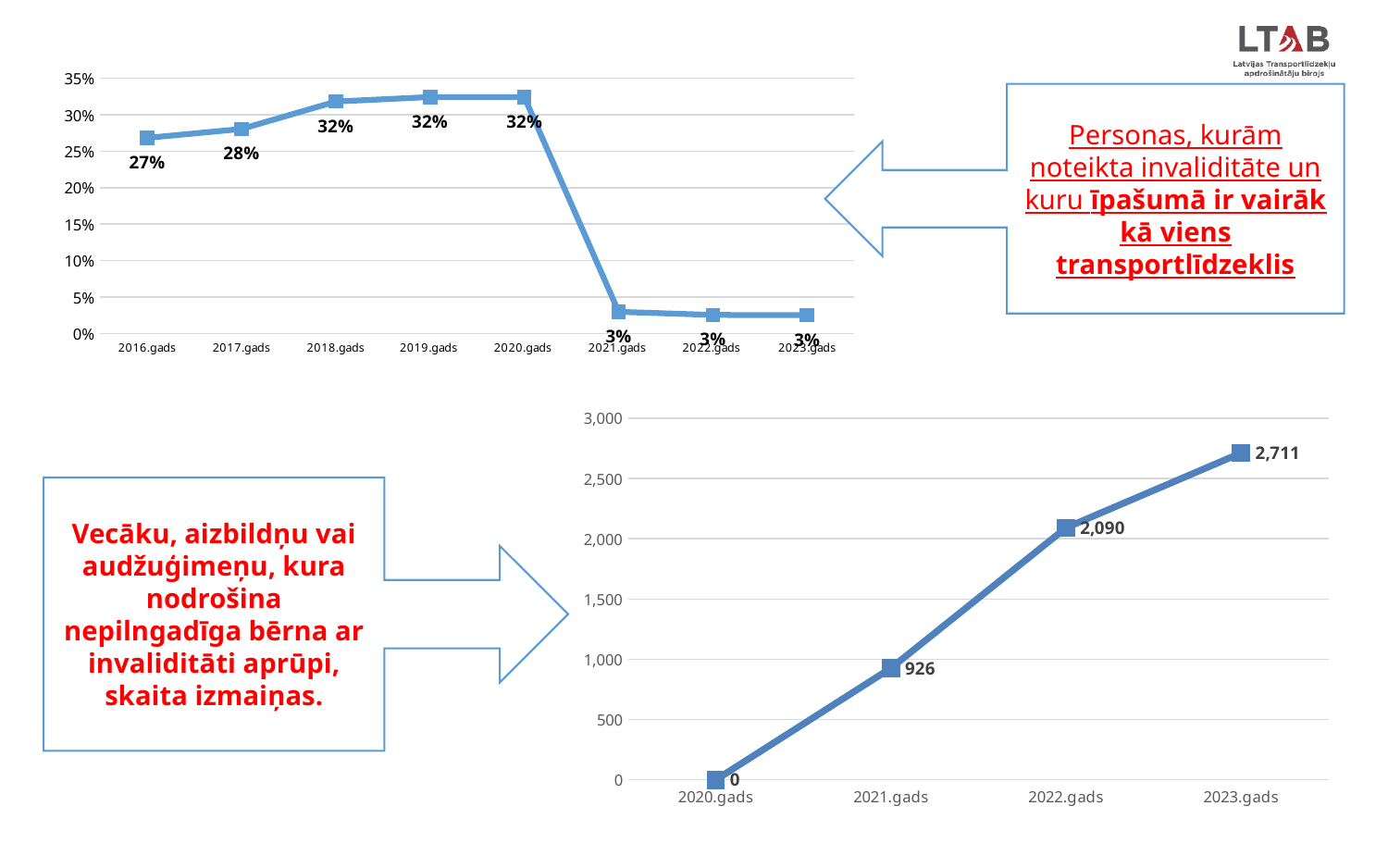
In the top-left chart, which value is larger, 2017.gads or 2018.gads? 2018.gads In the bottom-right chart, what is the difference between the values for 2023.gads and 2022.gads? 621 In the bottom-right chart, how many data points are plotted? 4 In the bottom-right chart, what is the value for 2022.gads? 2,090 In the top-left chart, what is the value for 2019.gads? 32% What kind of chart is the bottom-right chart? line chart In the bottom-right chart, which year has the highest value? 2023.gads In the top-left chart, what is the difference between the values for 2020.gads and 2021.gads? 29% In the top-left chart, how many years are plotted on the x axis? 8 In the top-left chart, what is the value for 2016.gads? 27% In the top-left chart, what is the value for 2022.gads? 3% In the top-left chart, do the values rise or fall between 2020.gads and 2021.gads? fall